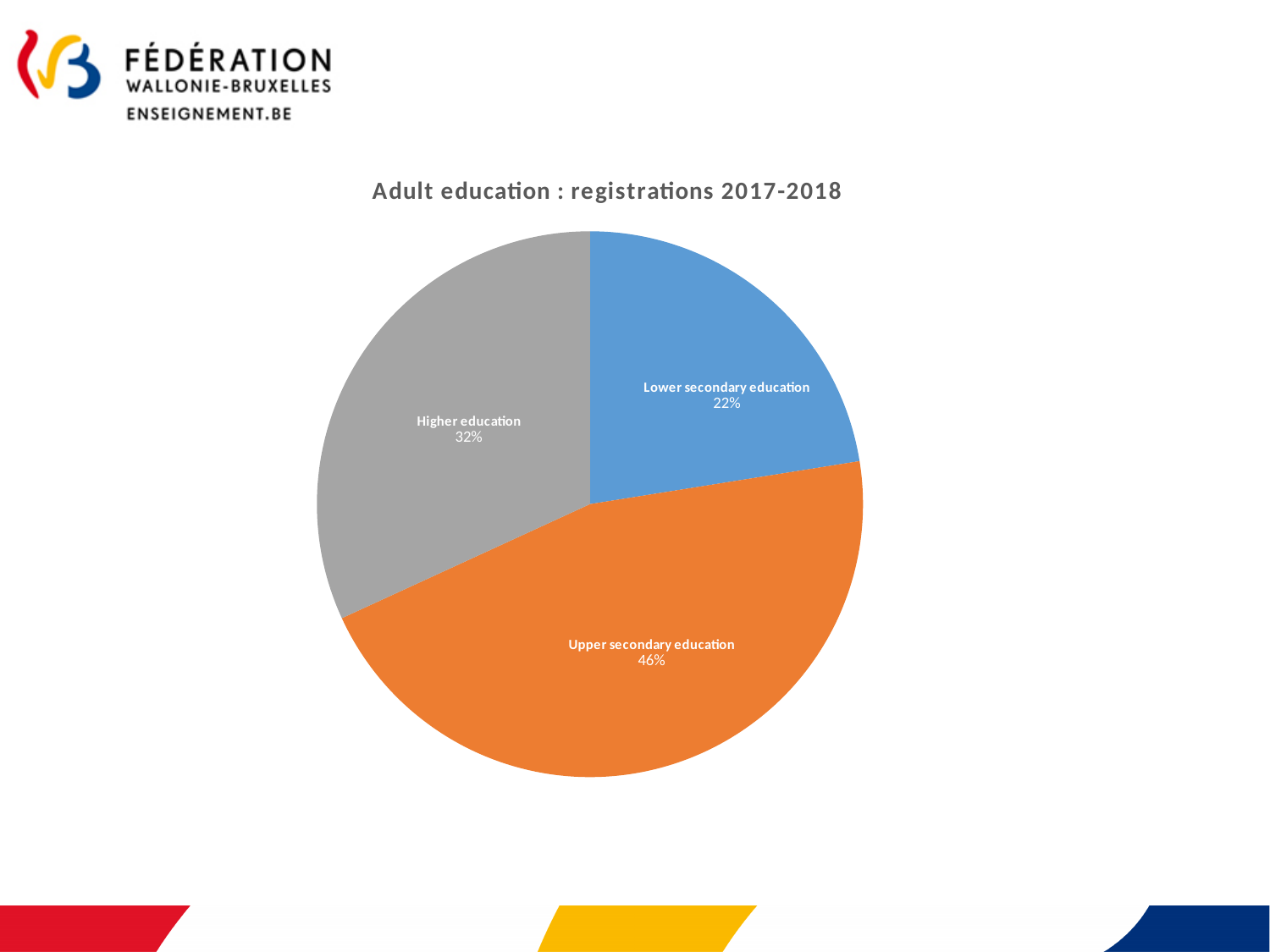
How many categories are shown in the pie chart? 3 What is the difference in percentage points between Upper secondary education and Higher education? 14 What is the title of the chart? Adult education : registrations 2017-2018 Which is larger, the share for Higher education or the share for Lower secondary education? Higher education What kind of chart is shown on the slide? Pie chart Which category has the smallest share of registrations? Lower secondary education What is the difference in percentage points between Higher education and Lower secondary education? 10 What share of registrations is Upper secondary education? 46% What share of registrations is Lower secondary education? 22% What share of registrations is Higher education? 32% What colour is the Upper secondary education slice? Orange Which category has the largest share of registrations? Upper secondary education